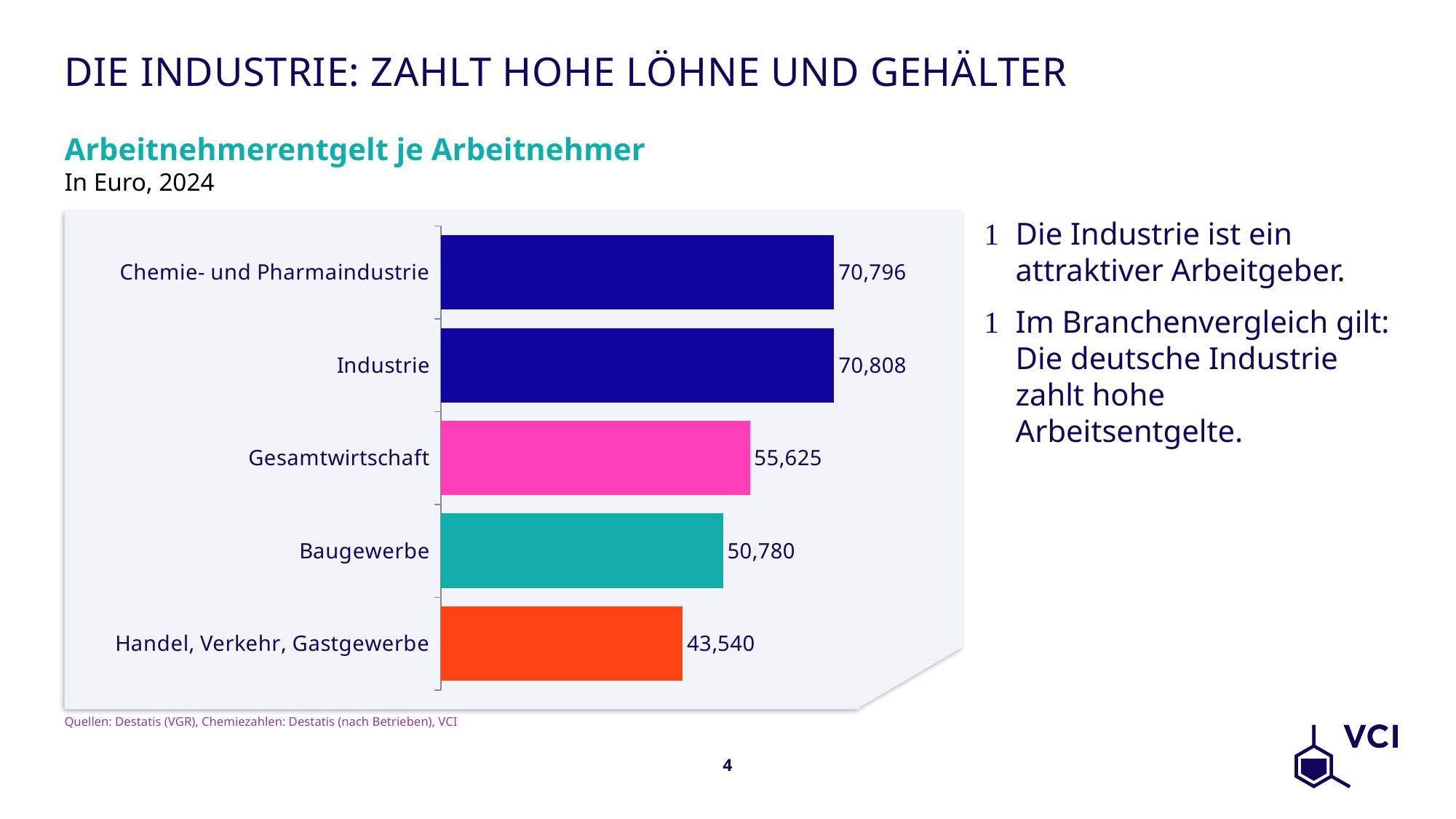
Which category has the lowest value? Handel, Verkehr, Gastgewerbe How many categories are shown in the chart? 5 What is the value for Baugewerbe? 50,780 What kind of chart is shown on the slide? Bar chart What is the value for Handel, Verkehr, Gastgewerbe? 43,540 What is the difference between the values for Baugewerbe and Handel, Verkehr, Gastgewerbe? 7,240 Which is larger, the value for Gesamtwirtschaft or the value for Baugewerbe? Gesamtwirtschaft What is the value for Gesamtwirtschaft? 55,625 What is the value for Chemie- und Pharmaindustrie? 70,796 What is the title of the chart? Arbeitnehmerentgelt je Arbeitnehmer What is the value for Industrie? 70,808 What is the difference between the values for Gesamtwirtschaft and Baugewerbe? 4,845